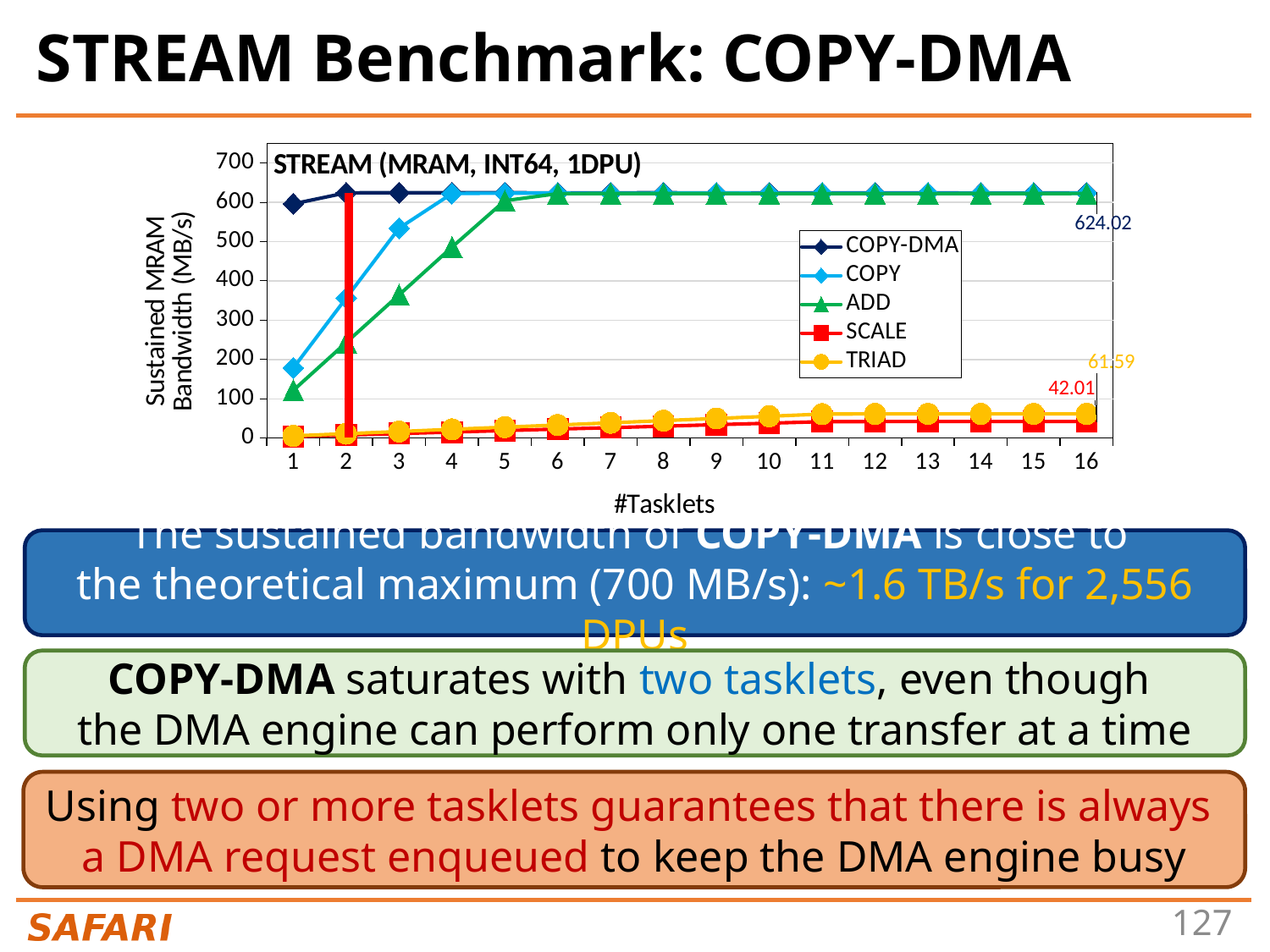
Which is larger at 2 tasklets, COPY or ADD? COPY What kind of chart is shown on the slide? line chart How many tasklet counts are plotted along the x axis? 16 What is the labelled value of SCALE at 16 tasklets? 42.01 What is the difference between the labelled TRIAD and SCALE values at 16 tasklets? 19.58 What is the labelled value of COPY-DMA at 16 tasklets? 624.02 What is the label of the x axis? #Tasklets What is the title printed inside the chart area? STREAM (MRAM, INT64, 1DPU) What is the labelled value of TRIAD at 16 tasklets? 61.59 Which series has the lowest bandwidth at 16 tasklets? SCALE How many series does the chart legend list? 5 Is the value for ADD at 1 tasklet greater or less than 200? less